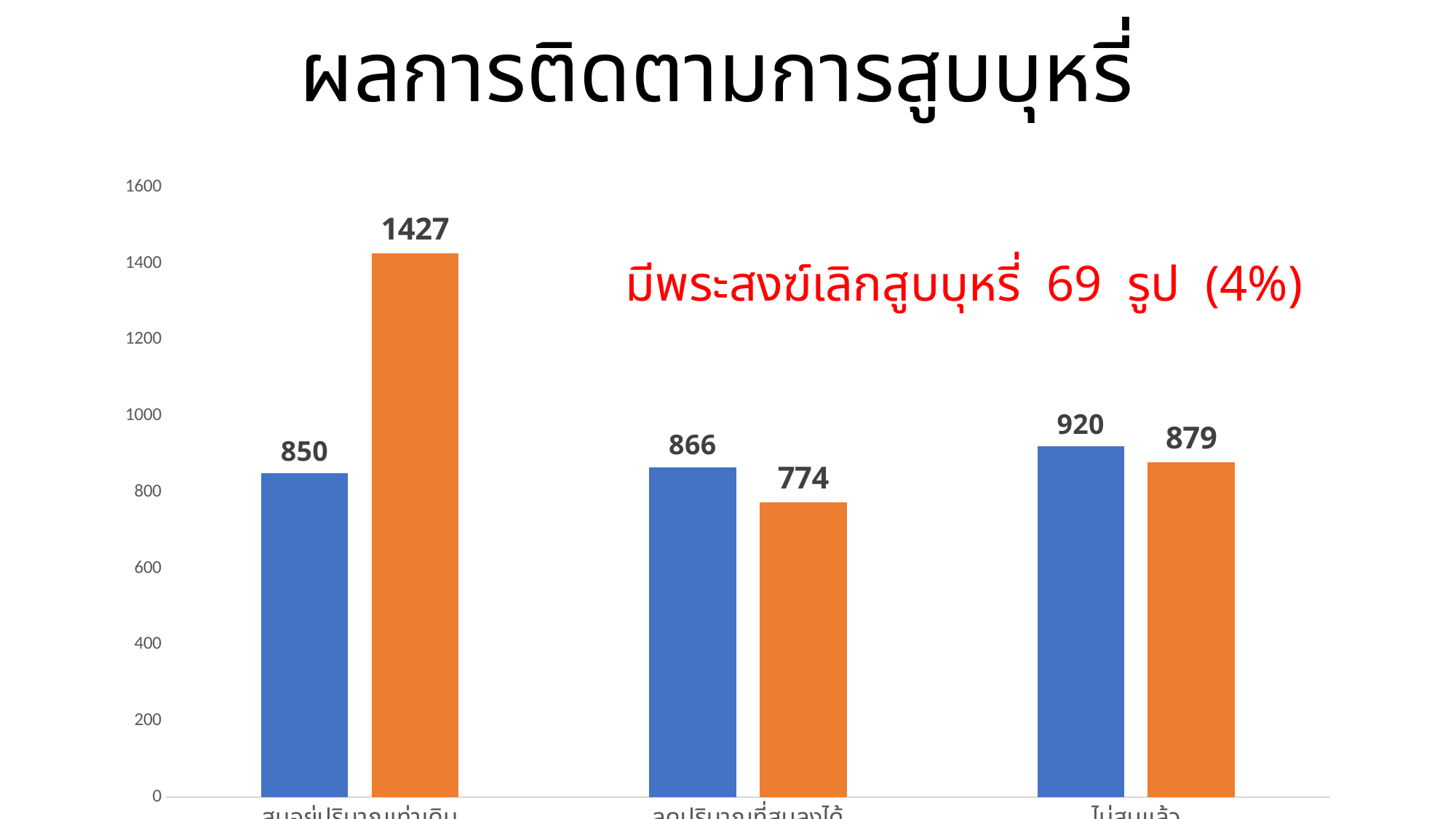
In the rightmost group, which bar is larger, the blue one or the orange one? the blue one (920) In the middle group, how much larger is the blue bar than the orange bar? 92 What is the value of the blue bar in the middle group? 866 What is the lowest value shown on the chart? 774 What is the value of the orange bar in the leftmost group? 1427 What is the difference between the orange bar and the blue bar in the leftmost group? 577 What is the value of the blue bar in the rightmost group? 920 Which bar has the highest value on the chart? the orange bar in the leftmost group (1427) How many bars are plotted in total on the chart? 6 What number of monks and percentage does the red text on the slide state quit smoking? 69 รูป (4%) What kind of chart is shown on the slide? bar chart How many category groups are plotted on the x axis of the chart? 3